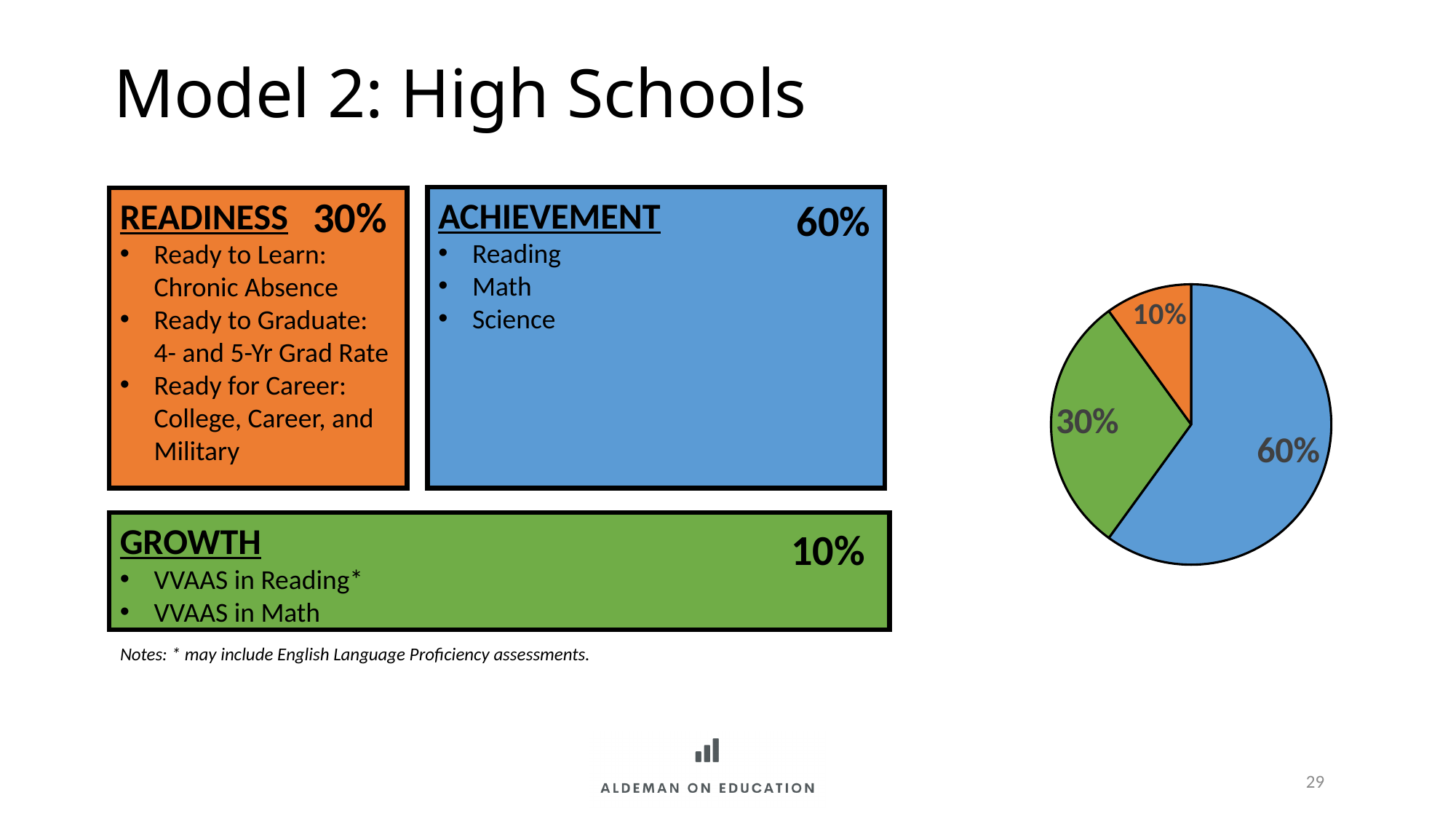
How many slices does the pie chart have? 3 Which slice of the pie chart is larger, the blue one or the green one? blue What is the difference between the blue slice and the green slice in the pie chart? 30% What percentage is shown on the blue slice of the pie chart? 60% What is the value of the smallest slice in the pie chart? 10% What kind of chart is shown on the right side of the slide? pie chart What colour is the largest slice of the pie chart? blue What is the value of the largest slice in the pie chart? 60% What percentage is shown on the green slice of the pie chart? 30% What percentage is shown on the orange slice of the pie chart? 10% What is the difference between the largest and smallest slices in the pie chart? 50% What colour is the smallest slice of the pie chart? orange